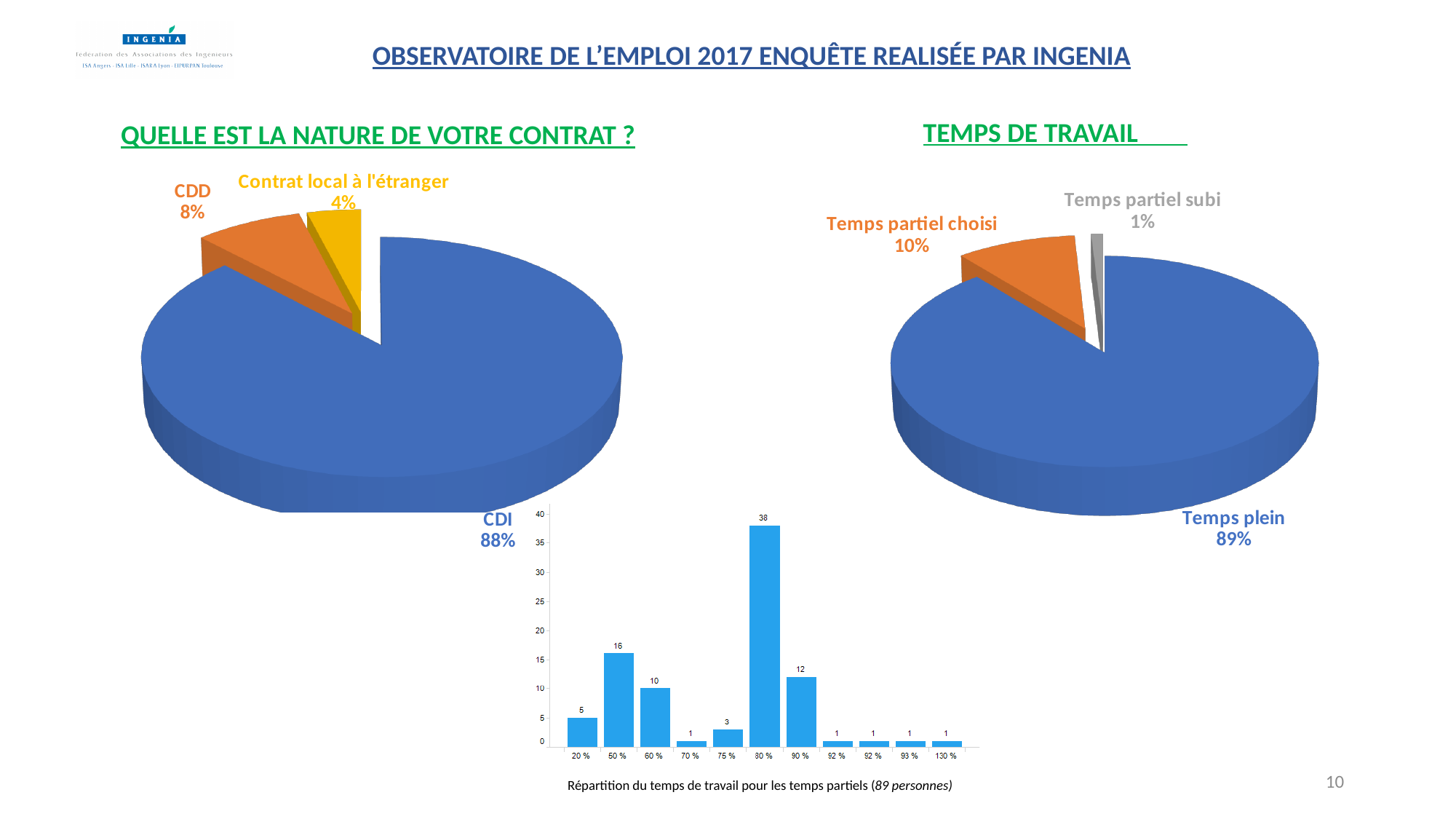
In the pie chart 'TEMPS DE TRAVAIL', which category has the largest share? Temps plein In the bar chart at the bottom of the slide, what is the difference between the values for 80 % and 90 %? 26 In the pie chart 'TEMPS DE TRAVAIL', how many slices are there? 3 In the pie chart 'TEMPS DE TRAVAIL', what share is Temps partiel choisi? 10% In the pie chart 'QUELLE EST LA NATURE DE VOTRE CONTRAT ?', what share is CDD? 8% In the pie chart 'QUELLE EST LA NATURE DE VOTRE CONTRAT ?', what is the difference in percentage points between CDD and Contrat local à l'étranger? 4 What type of chart is shown at the bottom of the slide? Bar chart In the pie chart 'QUELLE EST LA NATURE DE VOTRE CONTRAT ?', what share is CDI? 88% In the bar chart at the bottom of the slide, what is the value for 50 %? 16 In the bar chart at the bottom of the slide, what is the value for 80 %? 38 In the pie chart 'QUELLE EST LA NATURE DE VOTRE CONTRAT ?', which category has the smallest share? Contrat local à l'étranger In the bar chart at the bottom of the slide, which category has the highest value? 80 %